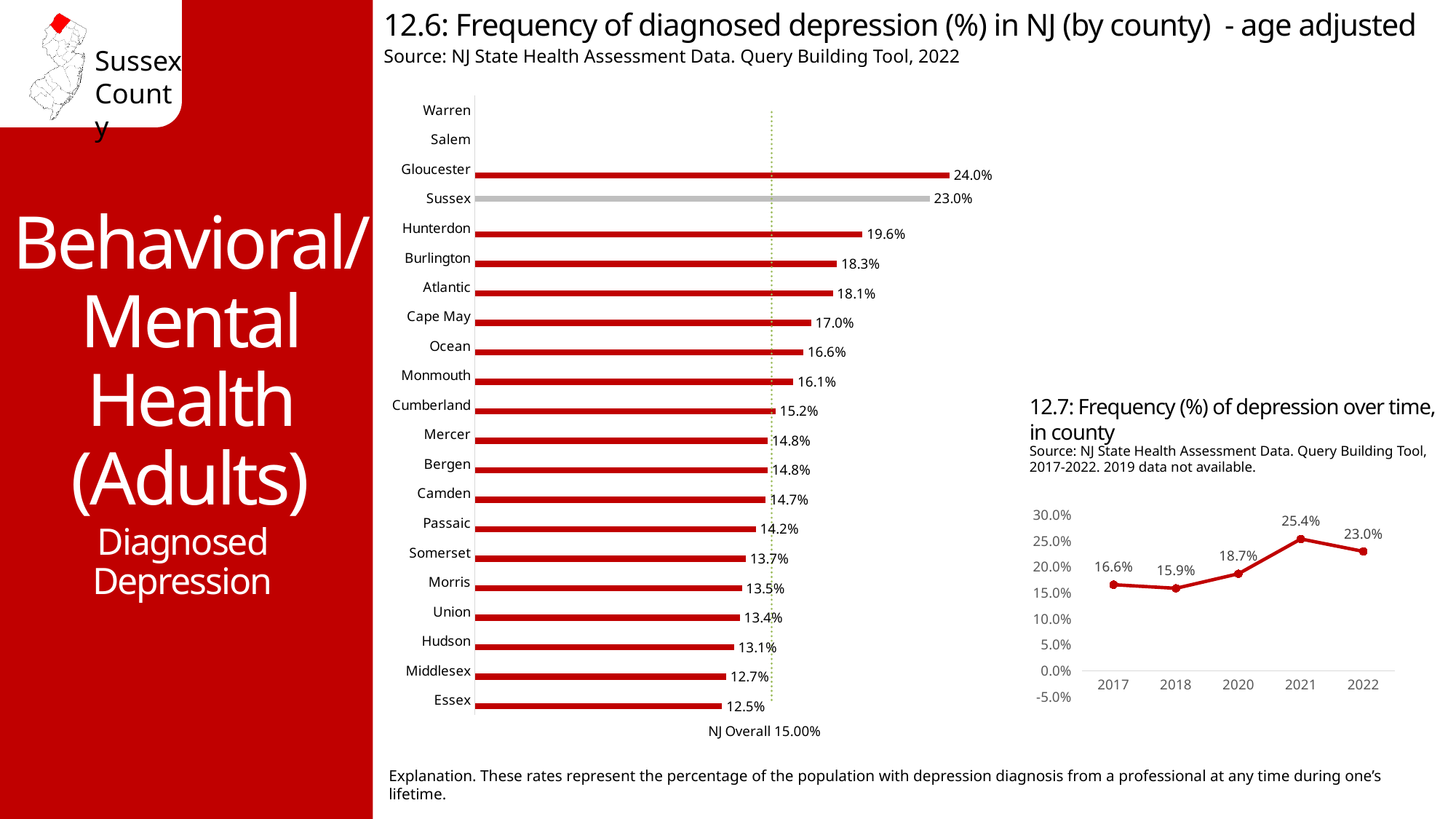
In chart 12.7, does the frequency of depression rise or fall from 2018 to 2021? Rise In chart 12.6, what is the value for Cape May? 17.0% In chart 12.7, how many data points are plotted? 5 In chart 12.6, what is the frequency of diagnosed depression for Sussex County? 23.0% In chart 12.7, what is the difference in percentage points between 2021 and 2022? 2.4 In chart 12.6, which county has the highest frequency of diagnosed depression? Gloucester What kind of chart is chart 12.6? Bar chart In chart 12.6, which county has a higher value, Hunterdon or Burlington? Hunterdon In chart 12.6, which county has the lowest value shown with a bar? Essex In chart 12.6, what is the difference in percentage points between Gloucester and Sussex? 1.0 In chart 12.6, what NJ Overall value is marked by the dotted reference line? 15.00% In chart 12.7, what was the frequency of depression in 2021? 25.4%